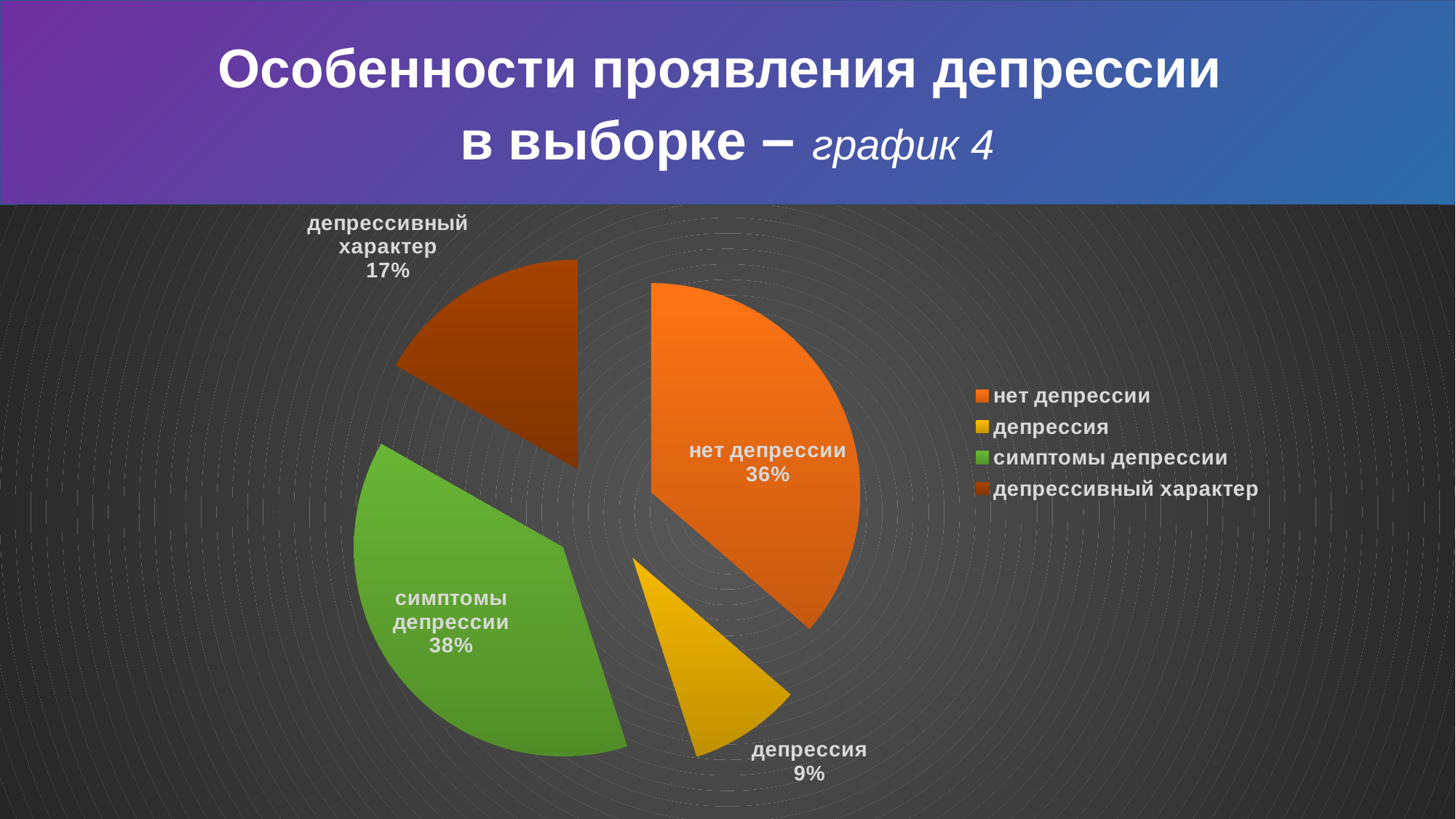
What is the difference in percentage points between "депрессивный характер" and "депрессия"? 8 What type of chart is shown on the slide? pie chart What share of the pie does "депрессия" represent? 9% Which is larger: the slice for "нет депрессии" or the slice for "депрессивный характер"? нет депрессии Which category has the largest slice of the pie? симптомы депрессии How many categories does the pie chart have? 4 Which category has the smallest slice of the pie? депрессия What is the difference in percentage points between "симптомы депрессии" and "нет депрессии"? 2 What share of the pie does "депрессивный характер" represent? 17% What share of the pie does "симптомы депрессии" represent? 38% What share of the pie does "нет депрессии" represent? 36% What colour is the slice for "депрессия"? yellow